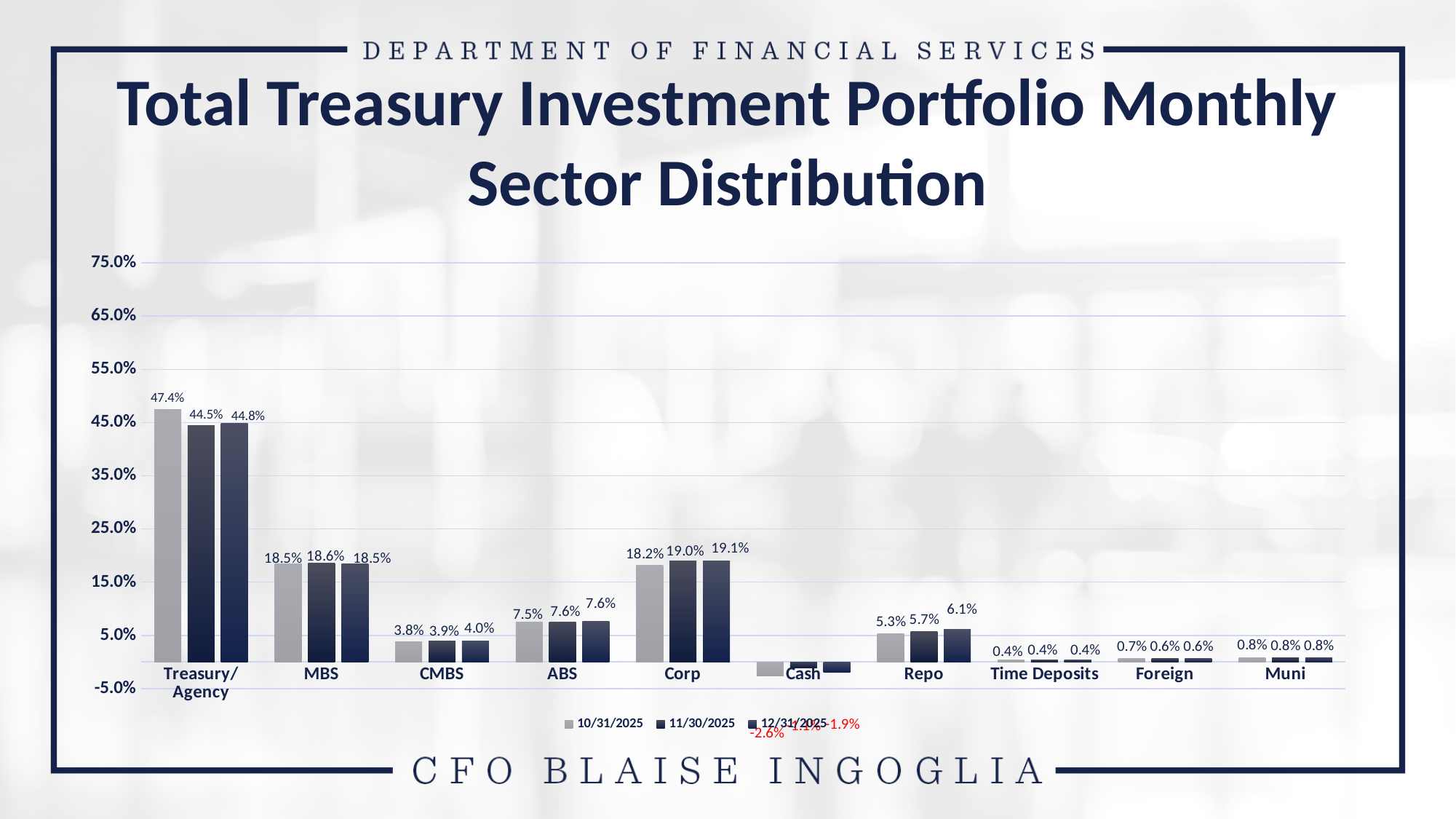
Which category has the lowest value in the 10/31/2025 series? Cash What is the value for Treasury/Agency in the 10/31/2025 series? 47.4% What kind of chart is shown on the slide? bar chart Which is larger for 12/31/2025: the value for MBS or the value for Corp? Corp What is the title of the chart? Total Treasury Investment Portfolio Monthly Sector Distribution Which category has the highest value in the 12/31/2025 series? Treasury/Agency What is the difference between the Treasury/Agency values for 10/31/2025 and 11/30/2025? 2.9% Is the value for ABS in the 10/31/2025 series greater or less than 15.0%? less What is the value for Repo in the 11/30/2025 series? 5.7% What is the value for Corp in the 12/31/2025 series? 19.1% How many categories are shown on the x axis? 10 How many series does the legend list? 3